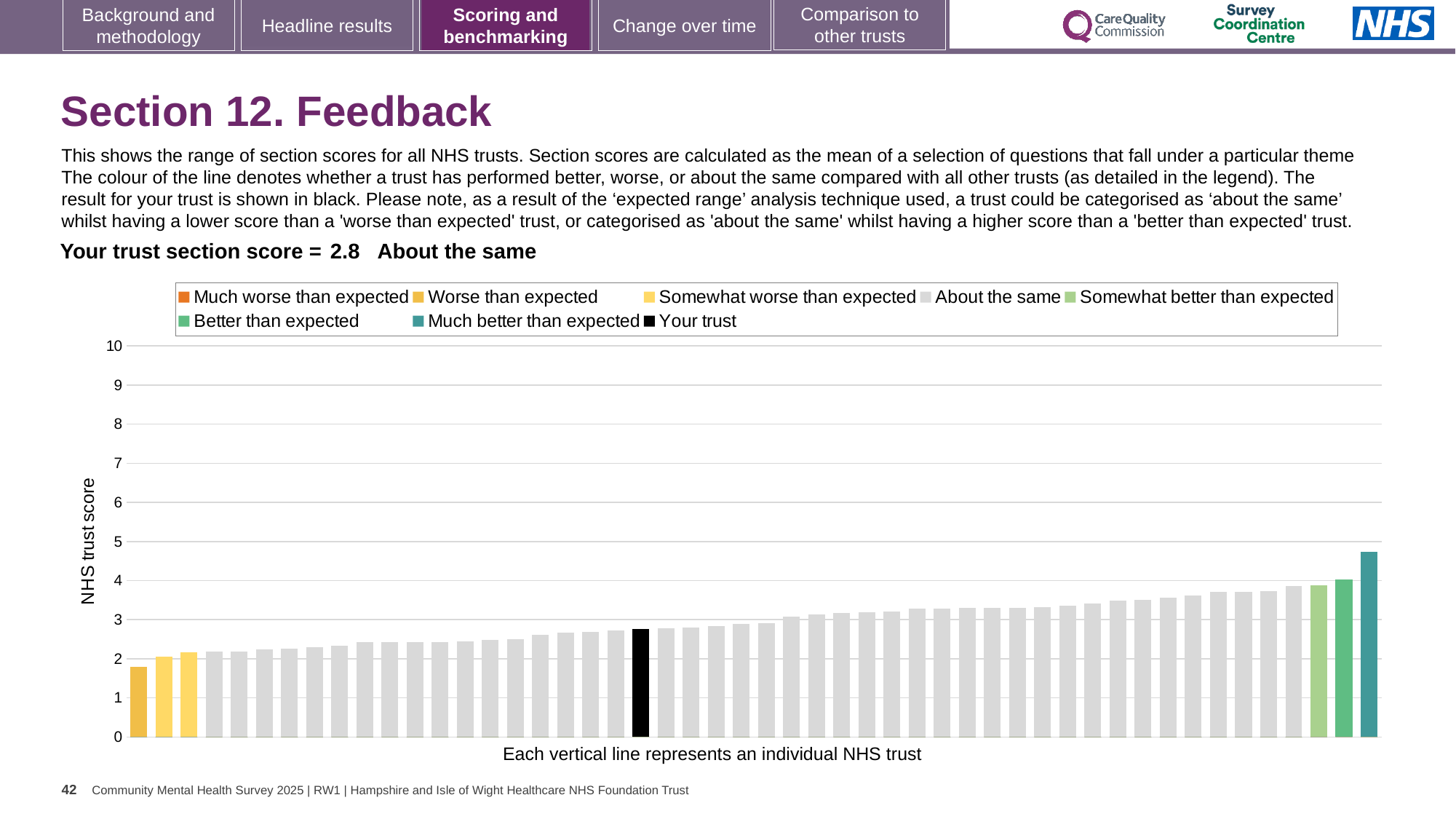
How many bars are coloured as 'Somewhat worse than expected'? 2 Do the bar values rise or fall from left to right across the chart? rise What is the label on the vertical axis of the chart? NHS trust score What does each vertical line in the chart represent? An individual NHS trust What is the trust's section score for Section 12. Feedback? 2.8 Is the value of the tallest bar in the chart greater or less than 4? greater How many entries does the chart legend list? 8 Is the value of the shortest bar in the chart greater or less than 2? less Is the value of the black 'Your trust' bar greater or less than 3? less How is the trust's section score categorised compared with other trusts? About the same How many bars are coloured as 'Much better than expected'? 1 What kind of chart is shown on the slide? bar chart